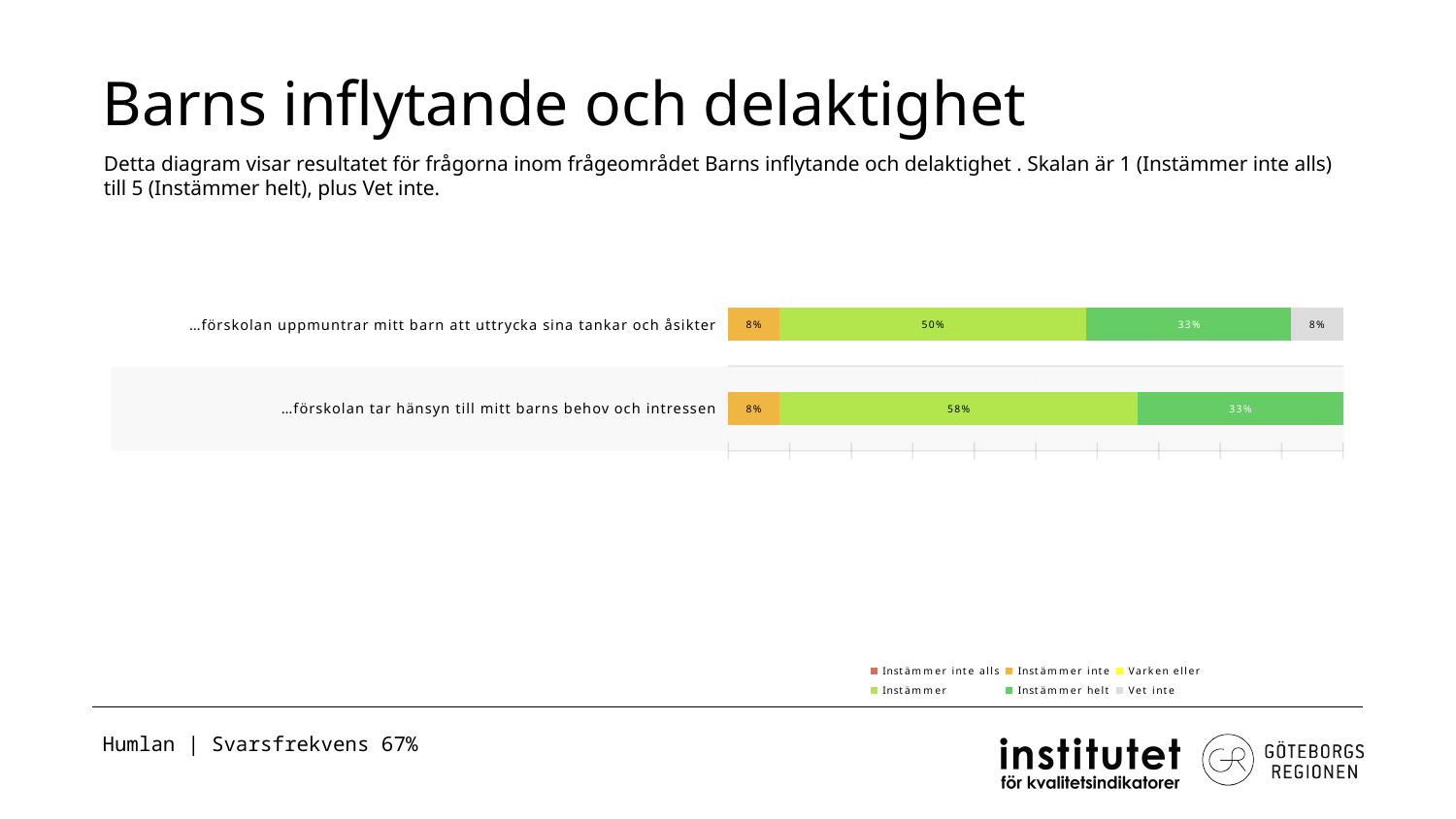
Is the 'Instämmer' value for '…förskolan uppmuntrar mitt barn att uttrycka sina tankar och åsikter' larger or smaller than the 'Instämmer helt' value for the same category? Larger What is the title of the slide containing the chart? Barns inflytande och delaktighet How many categories (questions) are plotted in the chart? 2 What is the 'Instämmer helt' value for '…förskolan tar hänsyn till mitt barns behov och intressen'? 33% What is the difference between the 'Instämmer' values of the two categories? 8% What is the 'Vet inte' value for '…förskolan uppmuntrar mitt barn att uttrycka sina tankar och åsikter'? 8% What is the 'Instämmer' value for '…förskolan tar hänsyn till mitt barns behov och intressen'? 58% Which legend entry is shown in grey? Vet inte Which category has the higher 'Instämmer' value? …förskolan tar hänsyn till mitt barns behov och intressen How many series does the legend list? 6 What kind of chart is shown on the slide? Stacked bar chart What is the 'Instämmer' value for '…förskolan uppmuntrar mitt barn att uttrycka sina tankar och åsikter'? 50%